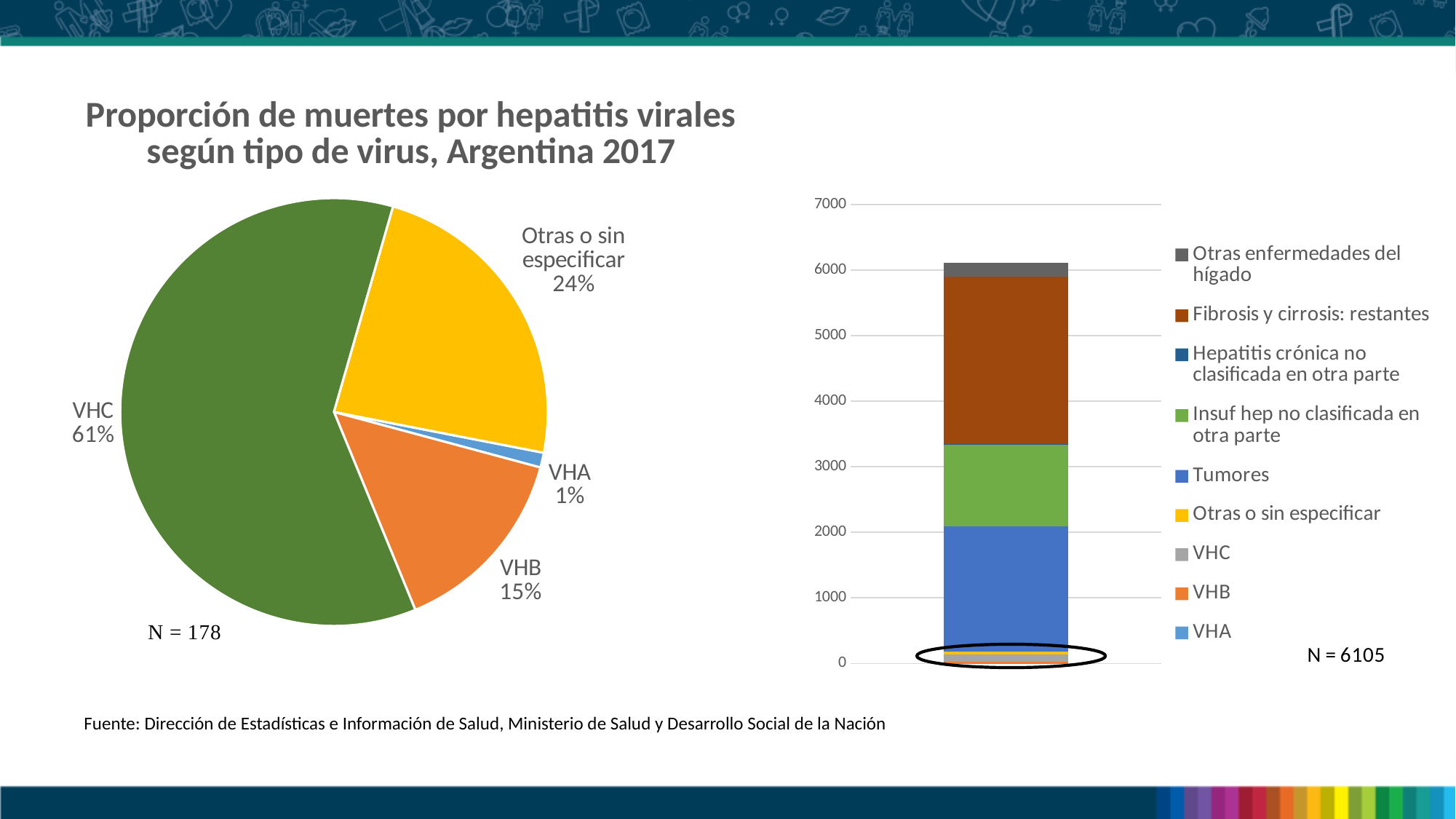
On the pie chart on the left, which virus type has the smallest share? VHA On the pie chart on the left, which category has the largest share? VHC On the pie chart on the left, what share of deaths is attributed to VHC? 61% On the chart on the right, is the total height of the stacked bar greater or less than 5000? greater On the pie chart on the left, what percentage is shown for 'Otras o sin especificar'? 24% On the pie chart on the left, what percentage is shown for VHB? 15% What is the N value shown below the pie chart on the left? N = 178 On the pie chart on the left, which is larger, the share for VHB or the share for VHA? VHB On the pie chart on the left, what is the difference in percentage points between VHC and 'Otras o sin especificar'? 37 How many slices does the pie chart on the left have? 4 How many series does the legend of the chart on the right list? 9 What kind of chart is shown on the right side of the slide? Stacked bar chart